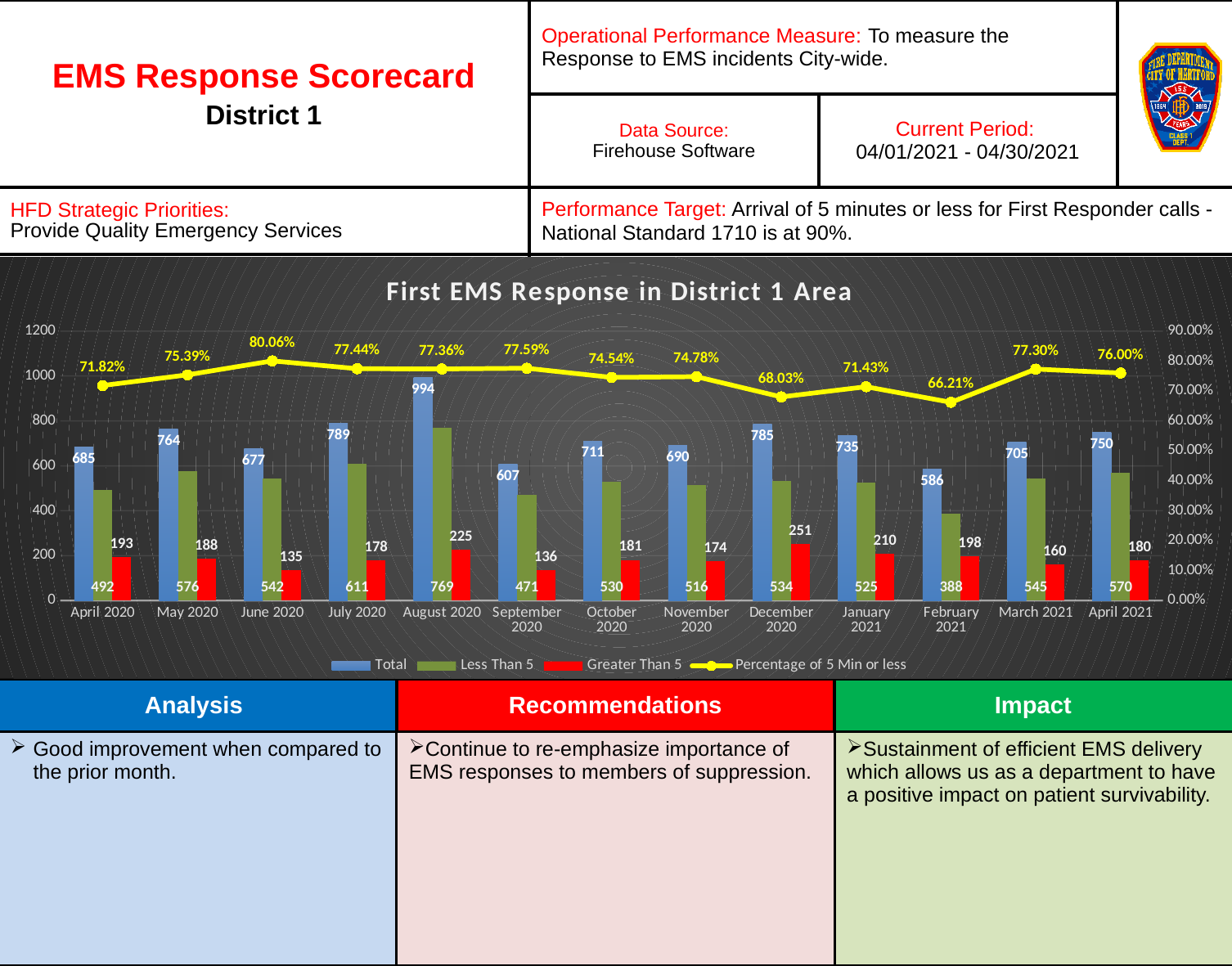
What colour is the line showing the Percentage of 5 Min or less? Yellow What is the Percentage of 5 Min or less for February 2021? 66.21% Which is larger, the Less Than 5 value for May 2020 or for June 2020? May 2020 How many series does the chart legend list? 4 Which month has the highest Total value? August 2020 Which month has the highest Percentage of 5 Min or less? June 2020 What is the Greater Than 5 value for December 2020? 251 Which month has the lowest Percentage of 5 Min or less? February 2021 What is the title of the chart on the slide? First EMS Response in District 1 Area How many months are shown along the x axis of the chart? 13 What is the Total value for August 2020? 994 What is the difference between the Total for April 2021 and the Total for March 2021? 45